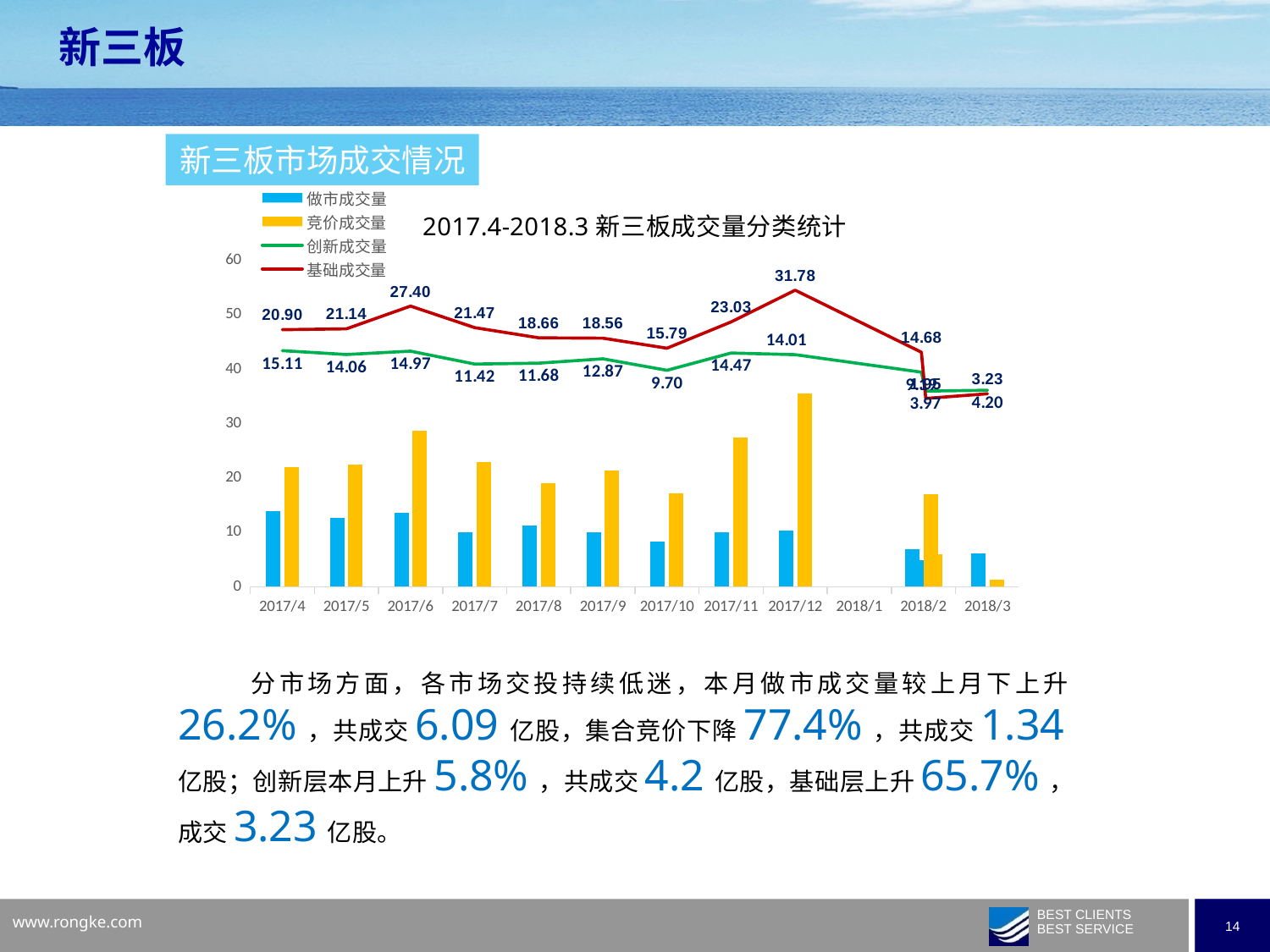
What is the difference between 基础成交量 in 2017/6 and 2017/5? 6.26 How many months are shown on the x axis of the chart? 12 Which month has the larger 创新成交量, 2017/4 or 2017/5? 2017/4 How many series does the chart legend list? 4 What is the value of 创新成交量 for 2017/11? 14.47 Is the 做市成交量 bar for 2017/4 greater or less than 10? greater Which month has the tallest 竞价成交量 bar? 2017/12 What is the value of 创新成交量 for 2017/10? 9.70 What is the value of 基础成交量 for 2017/12? 31.78 In which month is 基础成交量 the highest? 2017/12 In which month is 基础成交量 the lowest? 2018/2 Is the 竞价成交量 bar for 2017/12 greater or less than 30? greater